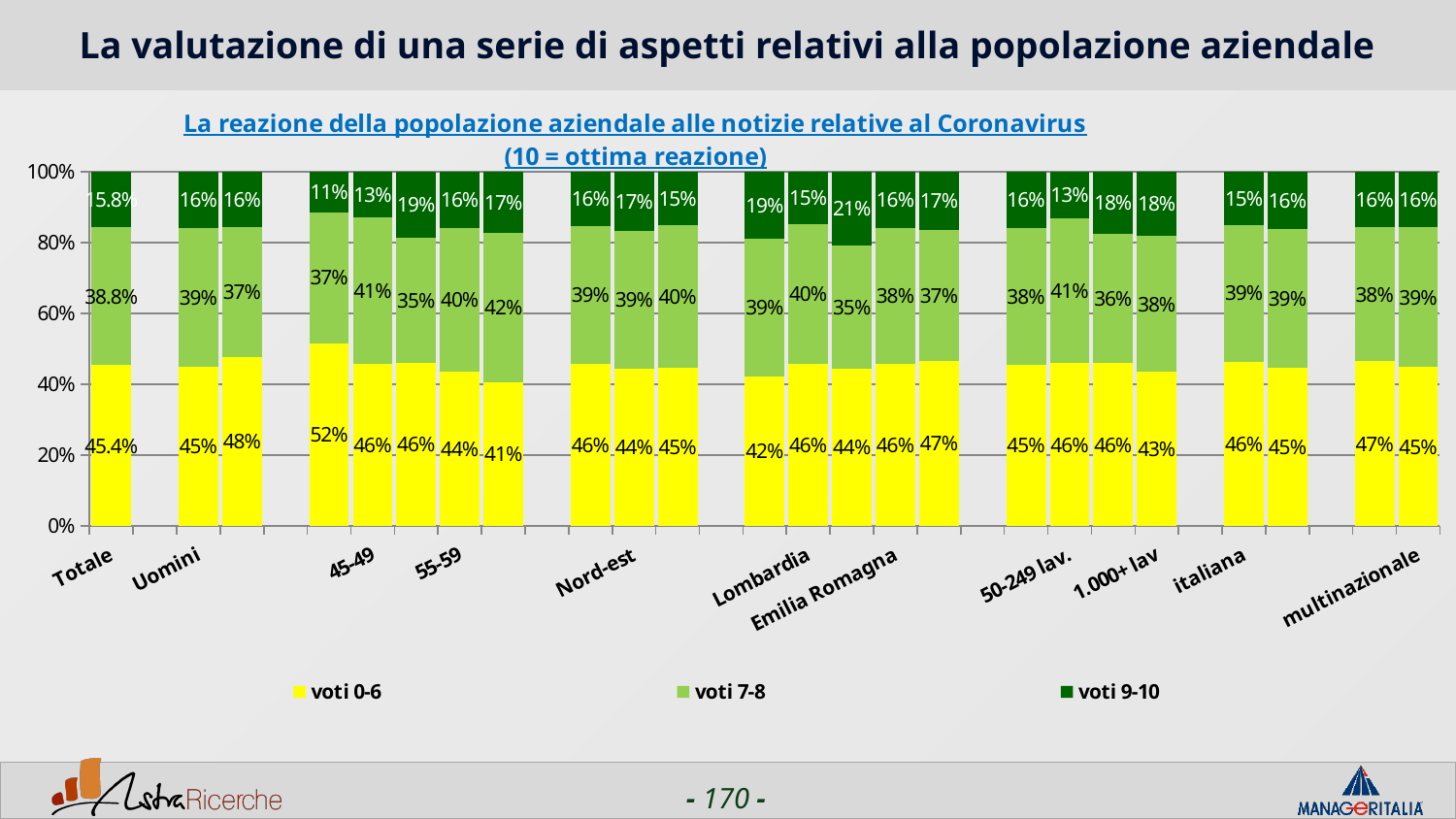
For Totale, which is larger: voti 0-6 or voti 7-8? voti 0-6 What is the difference between voti 0-6 and voti 9-10 for Uomini? 29% How many series does the legend list? 3 What are the three legend entries of the chart? voti 0-6, voti 7-8, voti 9-10 What is the value of voti 0-6 for Uomini? 45% What is the value of voti 9-10 for Totale? 15.8% What is the value of voti 0-6 for Totale? 45.4% What is the value of voti 0-6 for 55-59? 44% What is the value of voti 9-10 for 1.000+ lav? 18% What is the value of voti 7-8 for Totale? 38.8% What kind of chart is shown on the slide? stacked bar chart What is the value of voti 9-10 for 45-49? 13%